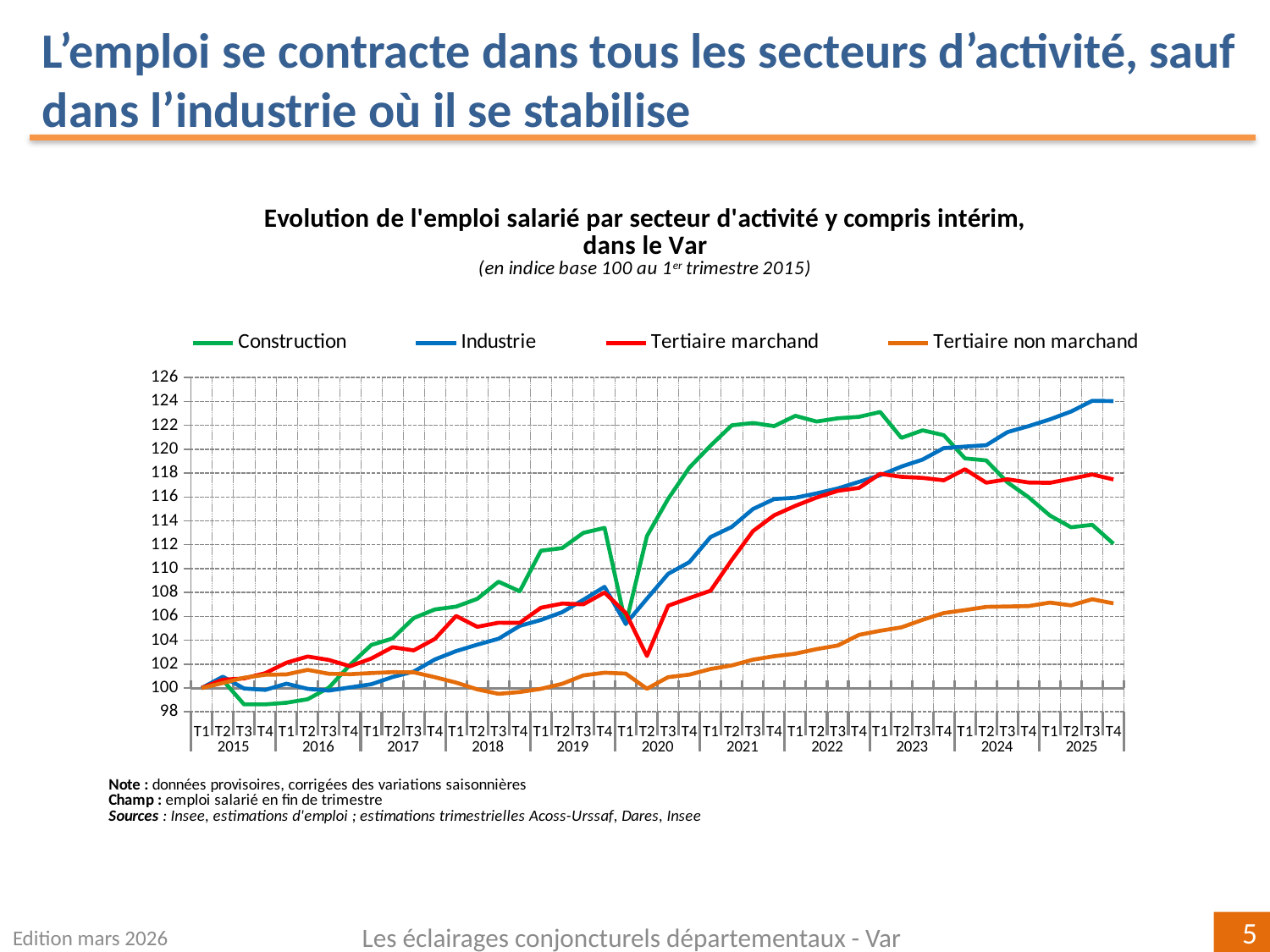
What is the index value of every series at T1 2015? 100 Which series are listed in the legend? Construction, Industrie, Tertiaire marchand, Tertiaire non marchand Is the value for Industrie at T4 2025 greater or less than 122? greater Which series has the lowest value at T4 2025? Tertiaire non marchand At T4 2025, which is higher: Industrie or Construction? Industrie How many series does the legend list? 4 Which series has the highest value at T4 2025? Industrie Is the value for Construction at T4 2025 greater or less than 114? less Does the Construction series rise or fall between T1 2023 and T4 2025? fall What kind of chart is shown on the slide? line chart Is the value for Tertiaire marchand at T2 2020 greater or less than 104? less